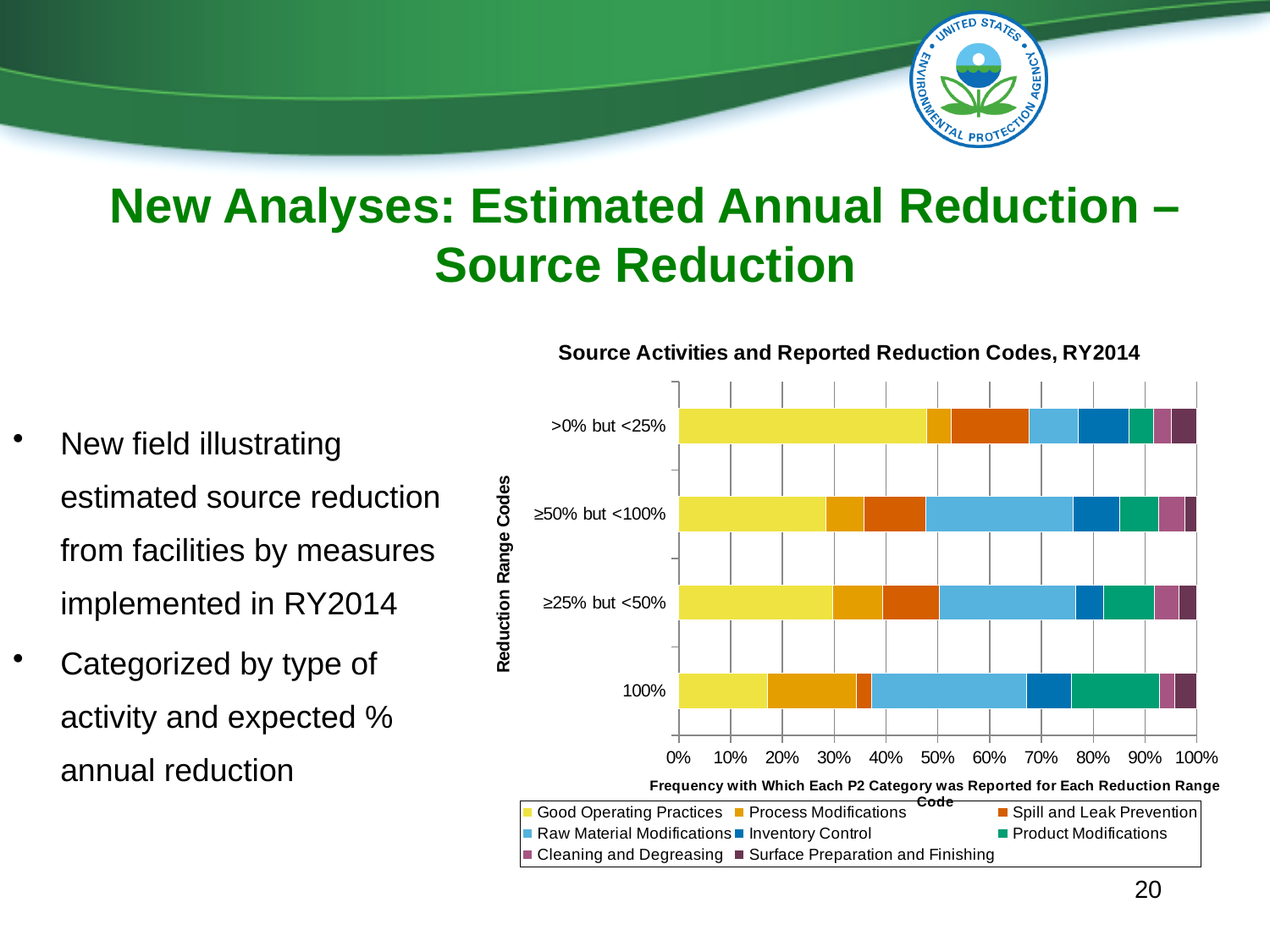
Is the Good Operating Practices share for the ">0% but <25%" bar greater or less than 40%? greater Which reduction range code has the smallest Good Operating Practices share? 100% Is the Raw Material Modifications segment larger for the "100%" bar or the ">0% but <25%" bar? 100% Which reduction range code has the largest Good Operating Practices share? >0% but <25% What is the title of the chart? Source Activities and Reported Reduction Codes, RY2014 How many series does the legend list? 8 What kind of chart is shown on the slide? Stacked bar chart How many reduction range code categories are plotted on the y axis? 4 Is the Raw Material Modifications share for the "100%" bar greater or less than 20%? greater What is the label of the y axis? Reduction Range Codes Is the Good Operating Practices share for the "100%" bar greater or less than 20%? less Is the Good Operating Practices segment larger for the ">0% but <25%" bar or the "≥50% but <100%" bar? >0% but <25%